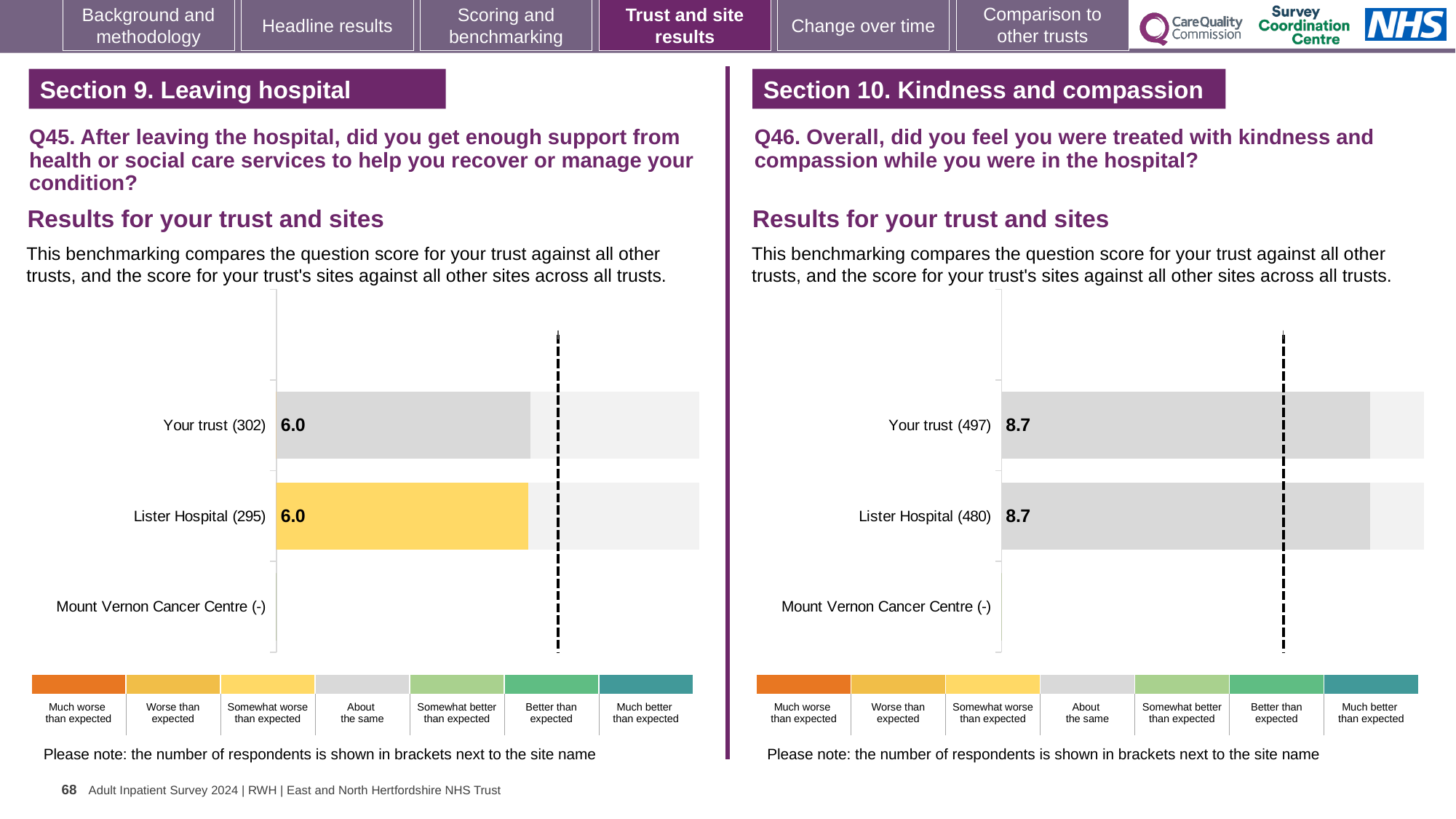
On the Q46 chart (right), how many categories are listed on the vertical axis? 3 On the Q46 chart (right), what is the score for Lister Hospital? 8.7 On the Q46 chart (right), what is the score for Your trust? 8.7 On the Q45 chart (left), what is the score for Lister Hospital? 6.0 What kind of chart is the Q46 chart (right)? Bar chart On the Q45 chart (left), what is the difference between the scores for Your trust and Lister Hospital? 0.0 On the Q45 chart (left), what is the score for Your trust? 6.0 On the Q45 chart (left), how many respondents are shown in brackets for Lister Hospital? 295 On the Q46 chart (right), how many respondents are shown in brackets for Your trust? 497 On the Q46 chart (right), which category has no score shown? Mount Vernon Cancer Centre On the Q45 chart (left), which benchmark category does the colour of the Lister Hospital bar correspond to? Somewhat worse than expected On the Q45 chart (left), how many categories are listed on the vertical axis? 3